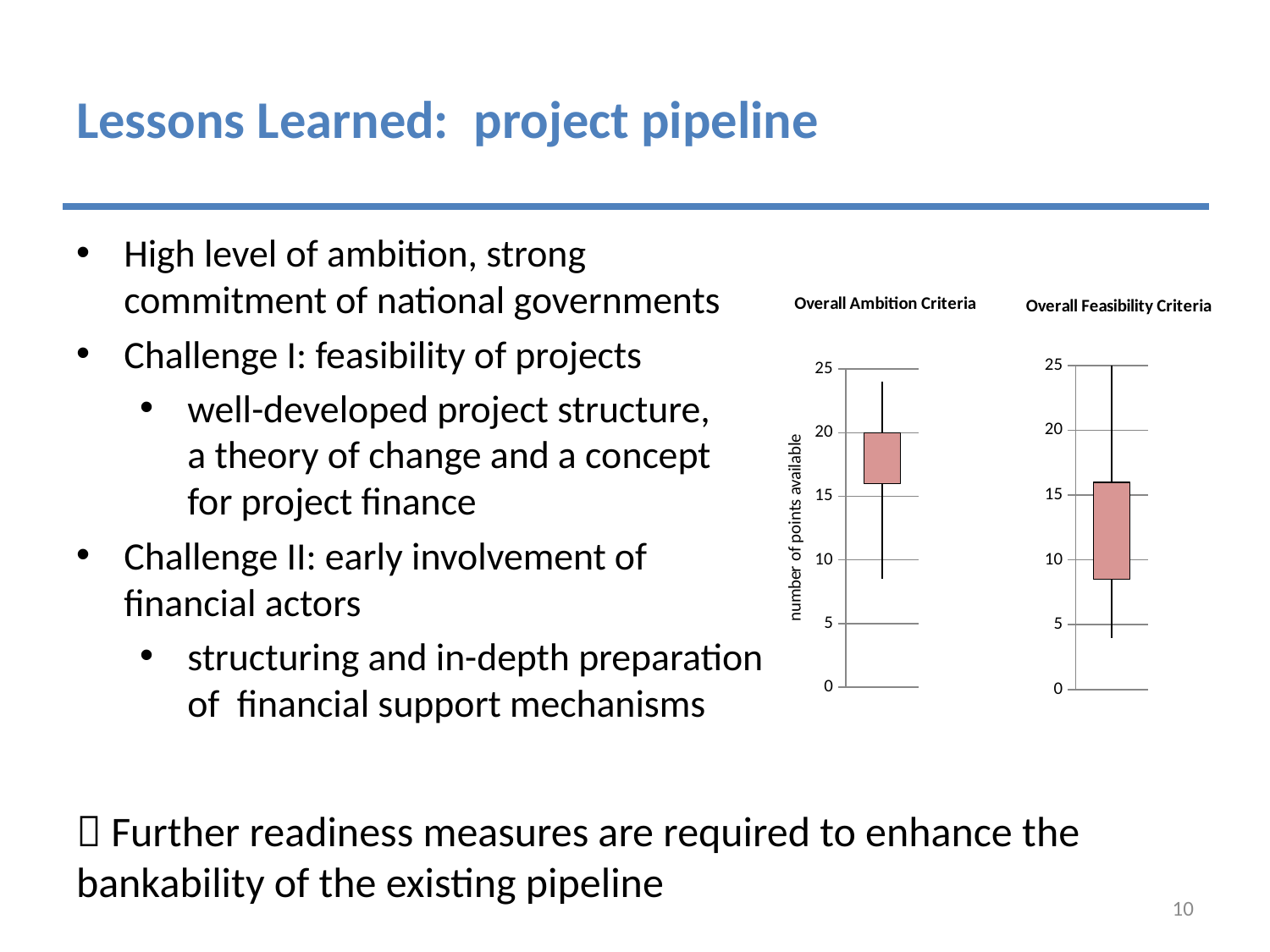
In the "Overall Feasibility Criteria" chart, is the lower end of the whisker greater or less than 5? less What is the highest tick value shown on the vertical axis of the "Overall Ambition Criteria" chart? 25 What is the label of the vertical axis on the "Overall Ambition Criteria" chart? number of points available In the "Overall Ambition Criteria" chart, is the lower end of the whisker greater or less than 5? greater Which chart has the higher top of its shaded box, "Overall Ambition Criteria" or "Overall Feasibility Criteria"? Overall Ambition Criteria Which chart has the lower bottom of its shaded box, "Overall Ambition Criteria" or "Overall Feasibility Criteria"? Overall Feasibility Criteria How many charts are shown on the slide? 2 In the "Overall Feasibility Criteria" chart, is the top of the shaded box greater or less than 20? less What is the title of the chart on the right side of the slide? Overall Feasibility Criteria What kind of chart is shown under the title "Overall Ambition Criteria"? box plot (box-and-whisker chart)